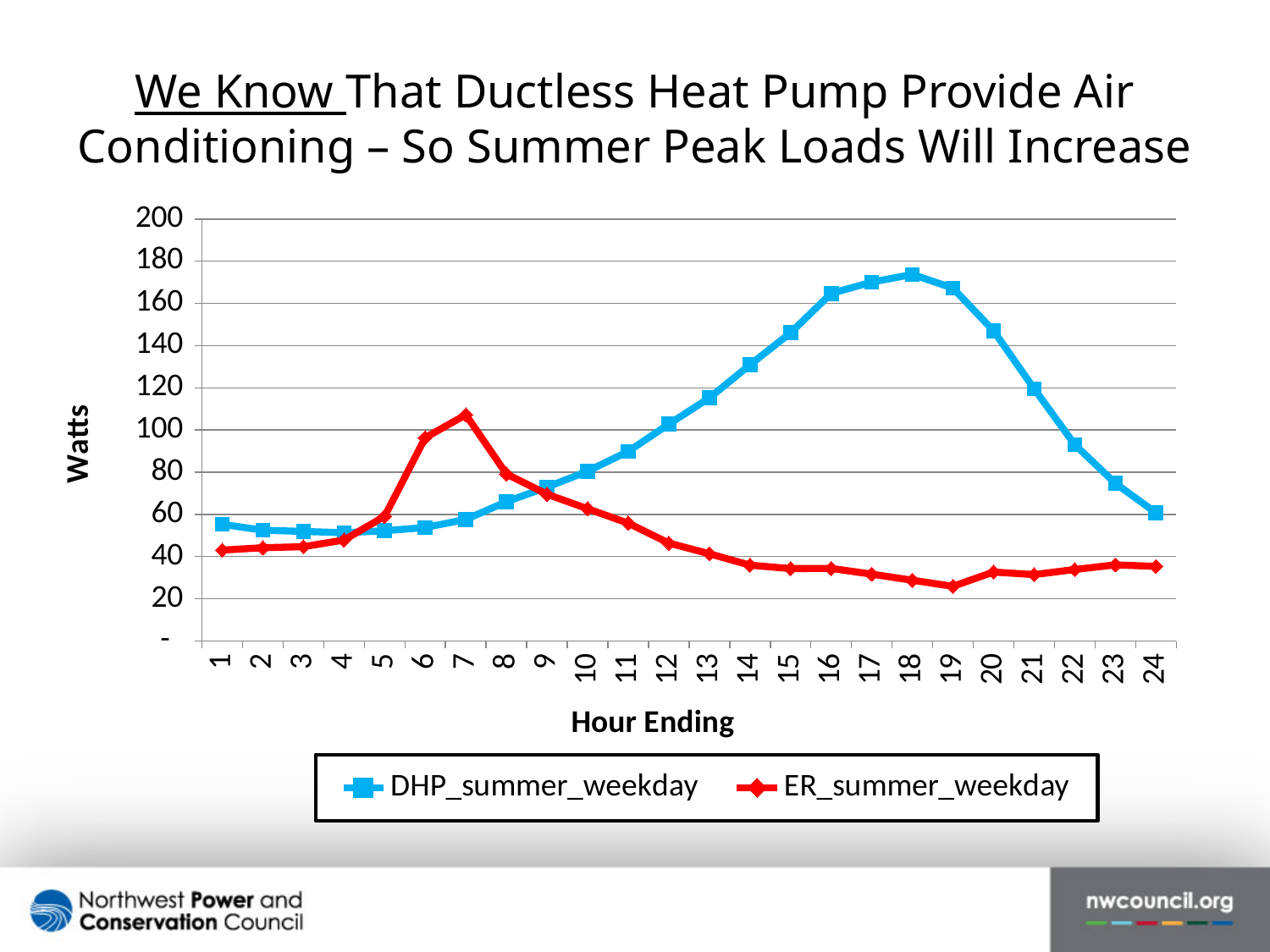
At hour ending 6, which series has the higher value, DHP_summer_weekday or ER_summer_weekday? ER_summer_weekday What are the two series named in the legend? DHP_summer_weekday and ER_summer_weekday At which hour ending does the ER_summer_weekday series reach its lowest value? 19 At which hour ending does the ER_summer_weekday series reach its highest value? 7 How many series does the legend list? 2 What kind of chart is shown on the slide? line chart What is the title of the vertical axis? Watts At which hour ending does the DHP_summer_weekday series reach its highest value? 18 Does the DHP_summer_weekday series rise or fall from hour ending 18 to hour ending 24? fall Is the ER_summer_weekday value at hour ending 14 greater or less than 40? less How many hours are plotted along the x axis? 24 Is the DHP_summer_weekday value at hour ending 18 greater or less than 160? greater